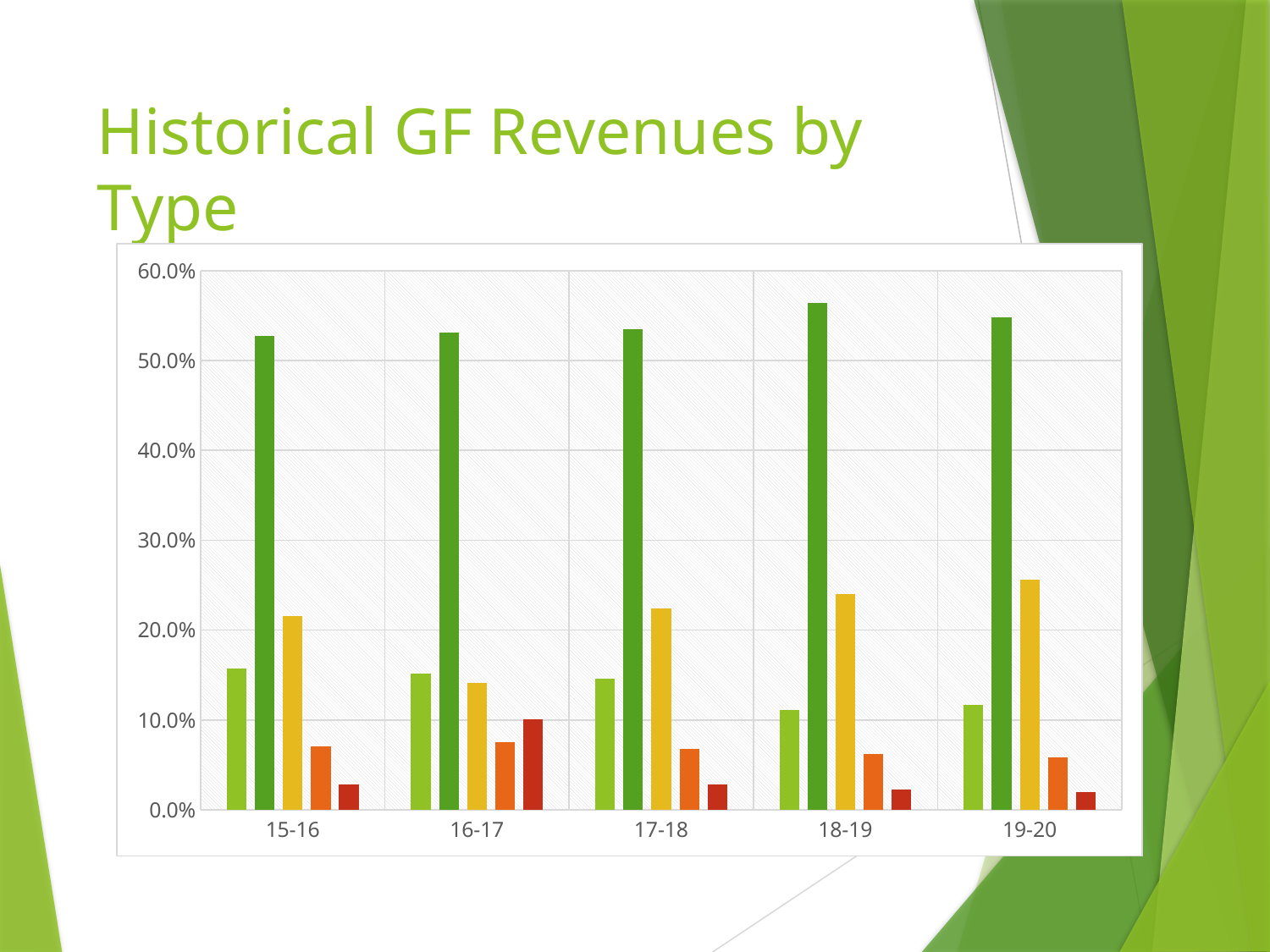
In which year is the dark green bar the tallest? 18-19 What is the title of the slide containing the chart? Historical GF Revenues by Type Is the value of the red bar for 16-17 greater or less than 5.0%? greater What kind of chart is shown on the slide? bar chart Is the value of the yellow bar for 19-20 greater or less than 20.0%? greater How many year categories are shown on the x axis? 5 Which is larger, the yellow bar for 15-16 or the yellow bar for 16-17? 15-16 Is the value of the light green bar for 18-19 greater or less than 20.0%? less What is the highest value shown on the y axis? 60.0% In which year is the red bar the tallest? 16-17 How many bars are plotted for each year group? 5